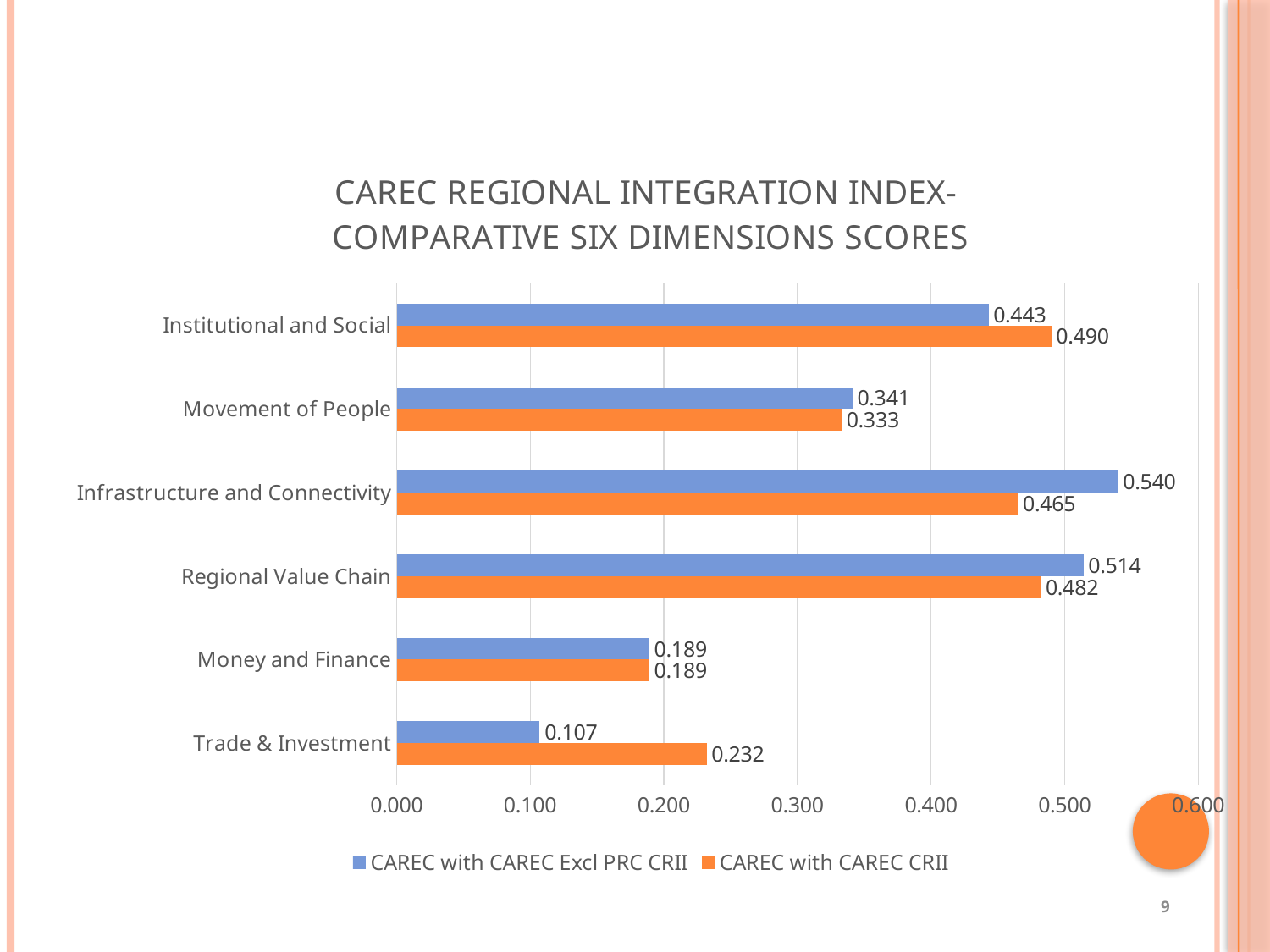
What is the value for Trade & Investment in the CAREC with CAREC CRII series? 0.232 Which category has the lowest value in the CAREC with CAREC CRII series? Money and Finance What is the difference between the two series' values for Trade & Investment? 0.125 What is the value for Institutional and Social in the CAREC with CAREC CRII series? 0.490 What type of chart is shown on the slide? Bar chart How many series does the legend list? 2 For Institutional and Social, which series has the larger value? CAREC with CAREC CRII Which category has the highest value in the CAREC with CAREC Excl PRC CRII series? Infrastructure and Connectivity What is the value for Infrastructure and Connectivity in the CAREC with CAREC Excl PRC CRII series? 0.540 Is the CAREC with CAREC Excl PRC CRII value for Regional Value Chain greater or less than 0.500? greater What is the difference between the two series' values for Infrastructure and Connectivity? 0.075 How many categories are shown on the chart? 6